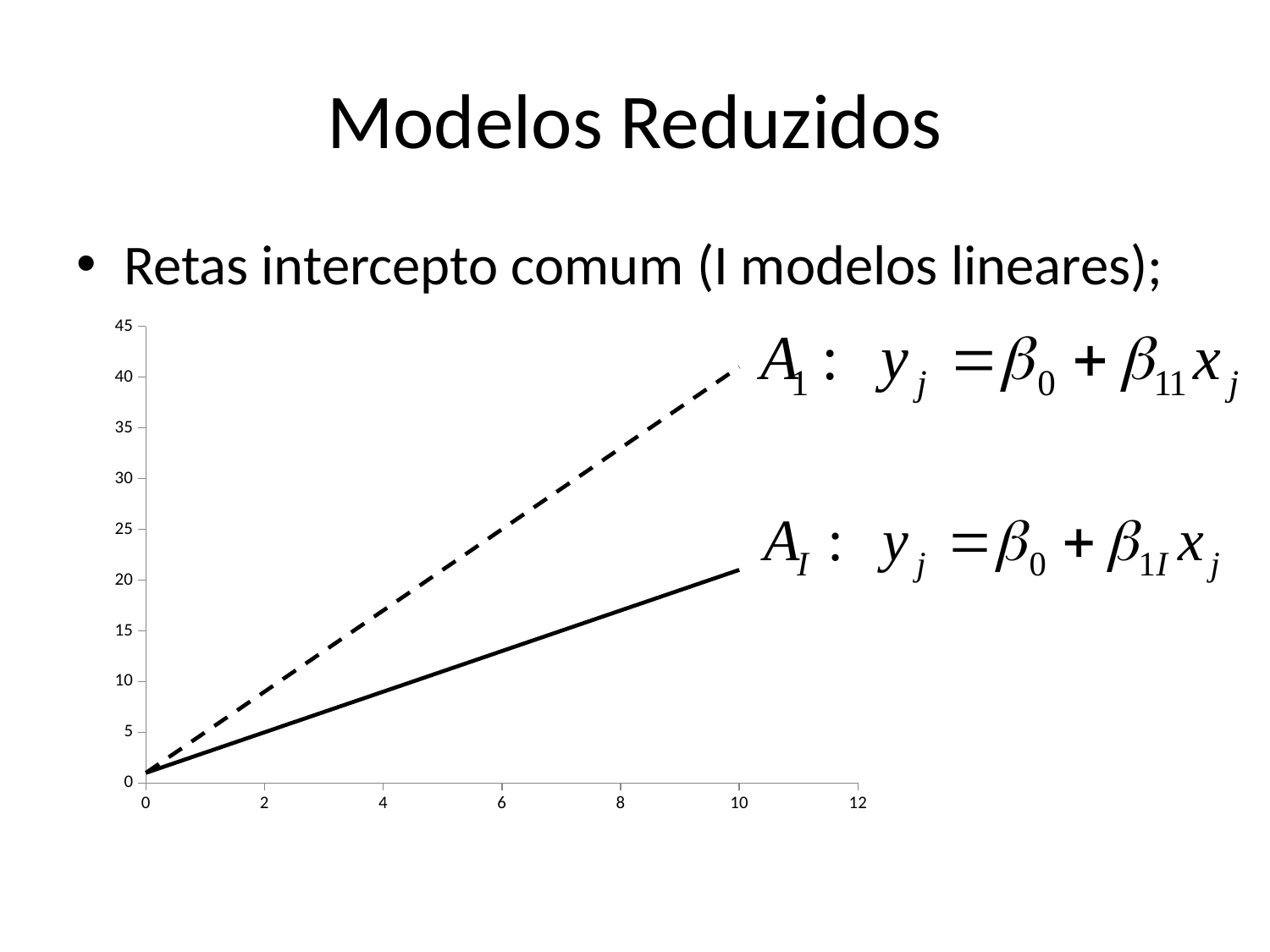
Is the value of the dashed line at x = 4 greater or less than 20? less Do the values of the solid line rise or fall as x increases? rise Which line is steeper, the dashed line or the solid line? the dashed line How many lines are plotted on the chart? 2 Do the values of the dashed line rise or fall as x increases? rise What is the highest tick value shown on the y axis? 45 What kind of chart is shown on the slide? line chart What is the highest tick value shown on the x axis? 12 At x = 10, which line has the higher value, the dashed line or the solid line? the dashed line Is the value of the solid line at x = 10 greater or less than 15? greater Is the value of the solid line at x = 10 greater or less than 25? less